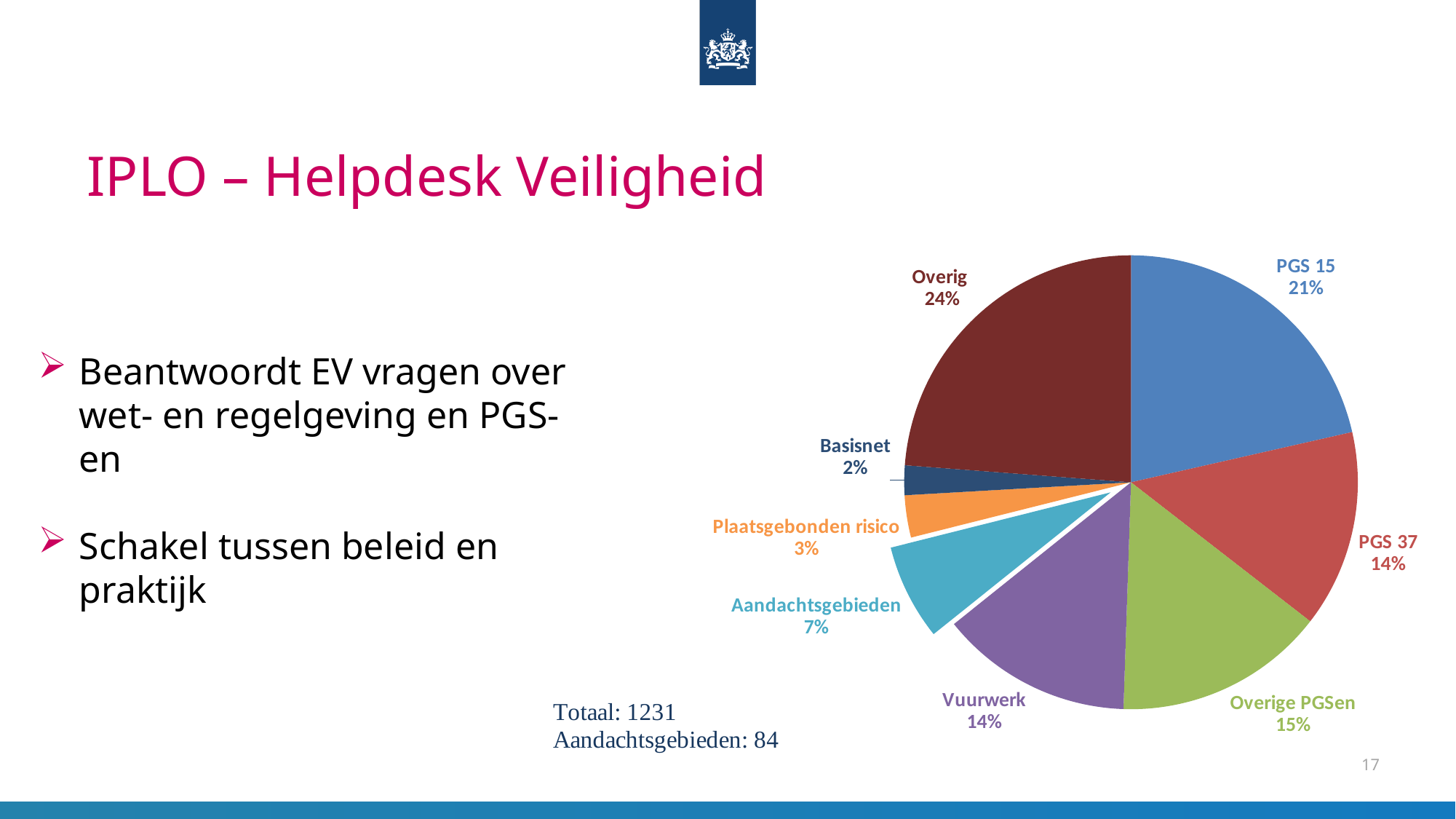
What share of the pie does Aandachtsgebieden represent? 7% Which category has the largest slice of the pie? Overig What is the difference in percentage points between Aandachtsgebieden and Plaatsgebonden risico? 4 What share of the pie does Basisnet represent? 2% What colour is the Vuurwerk slice of the pie? purple What share of the pie does PGS 15 represent? 21% Which category has the smallest slice of the pie? Basisnet How many slices does the pie chart have? 8 Which is larger, the share for Overige PGSen or the share for Vuurwerk? Overige PGSen What kind of chart is shown on the slide? pie chart What is the difference in percentage points between Overig and PGS 15? 3